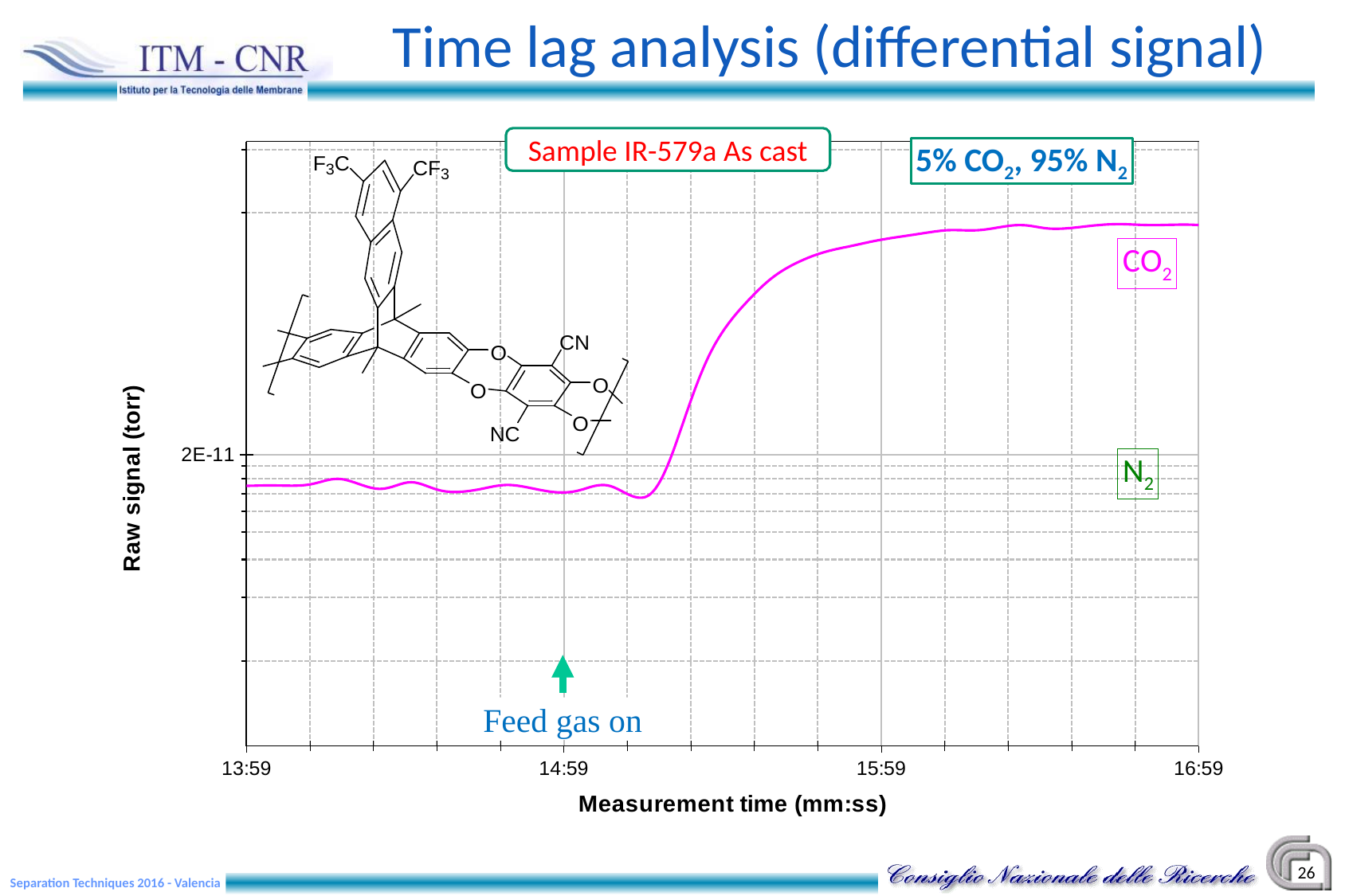
What kind of chart is shown on the slide? line chart Is the raw signal at 16:59 greater or less than 2E-11 torr? greater How many data lines are plotted on the chart? 1 How many time labels are printed on the x axis? 4 At what measurement time does the 'Feed gas on' arrow point? 14:59 Which is larger, the raw signal at 13:59 or at 16:59? 16:59 Is the raw signal at 13:59 greater or less than 2E-11 torr? less What feed gas mixture is stated on the chart? 5% CO2, 95% N2 What is the label of the x axis? Measurement time (mm:ss) Does the raw signal rise or fall between 14:59 and 15:59? rise